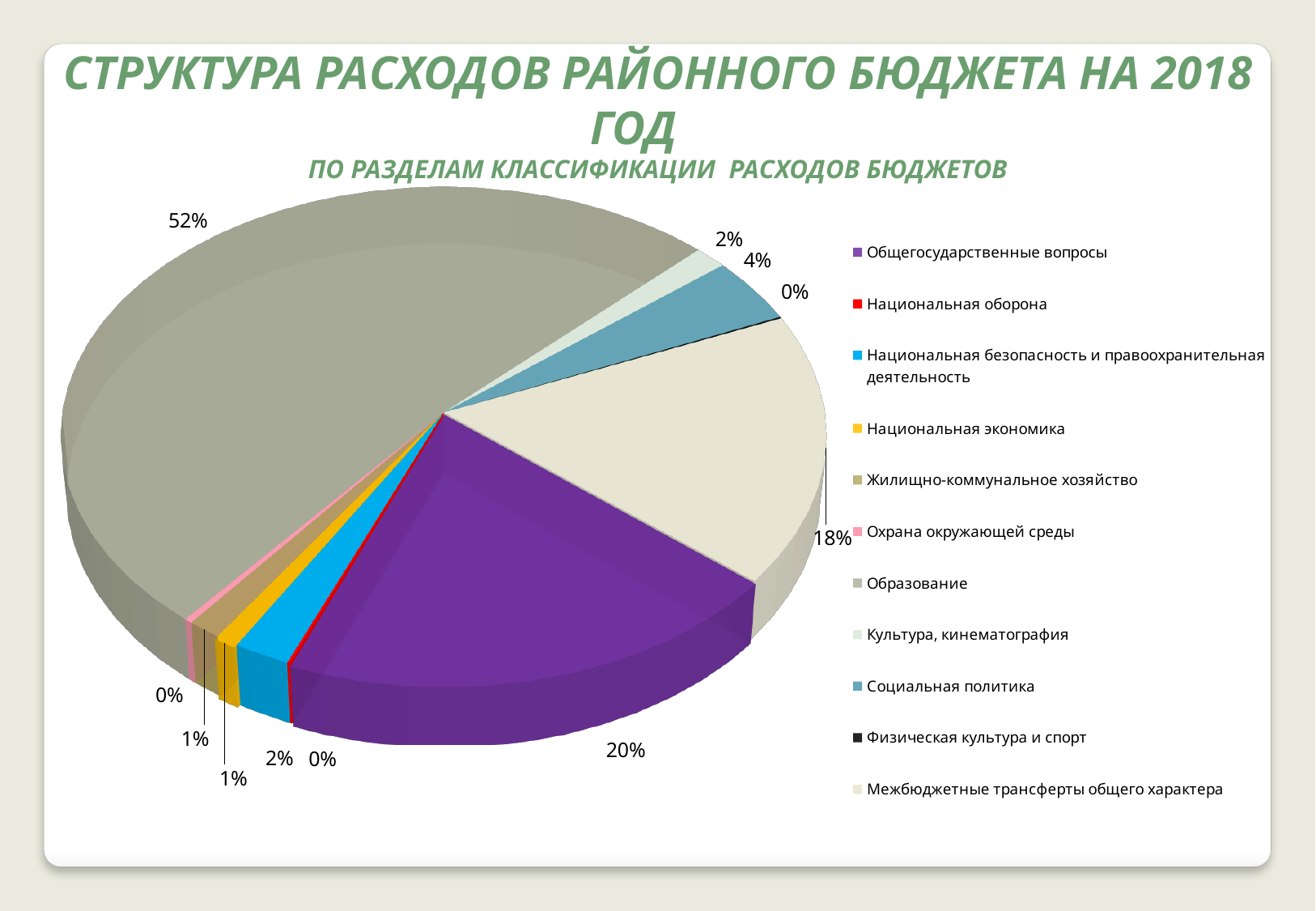
What colour is the slice for Общегосударственные вопросы? Purple What is the difference in percentage points between Образование and Общегосударственные вопросы? 32 Which is larger, the slice for Общегосударственные вопросы or the slice for Межбюджетные трансферты общего характера? Общегосударственные вопросы What kind of chart is shown on the slide? Pie chart What share of the pie does Общегосударственные вопросы have? 20% What share of the pie does Социальная политика have? 4% How many categories does the legend list? 11 What share of the pie does Культура, кинематография have? 2% What share of the pie does Национальная экономика have? 1% Which category has the largest slice of the pie? Образование What share of the pie does Межбюджетные трансферты общего характера have? 18% What share of the pie does Образование have? 52%